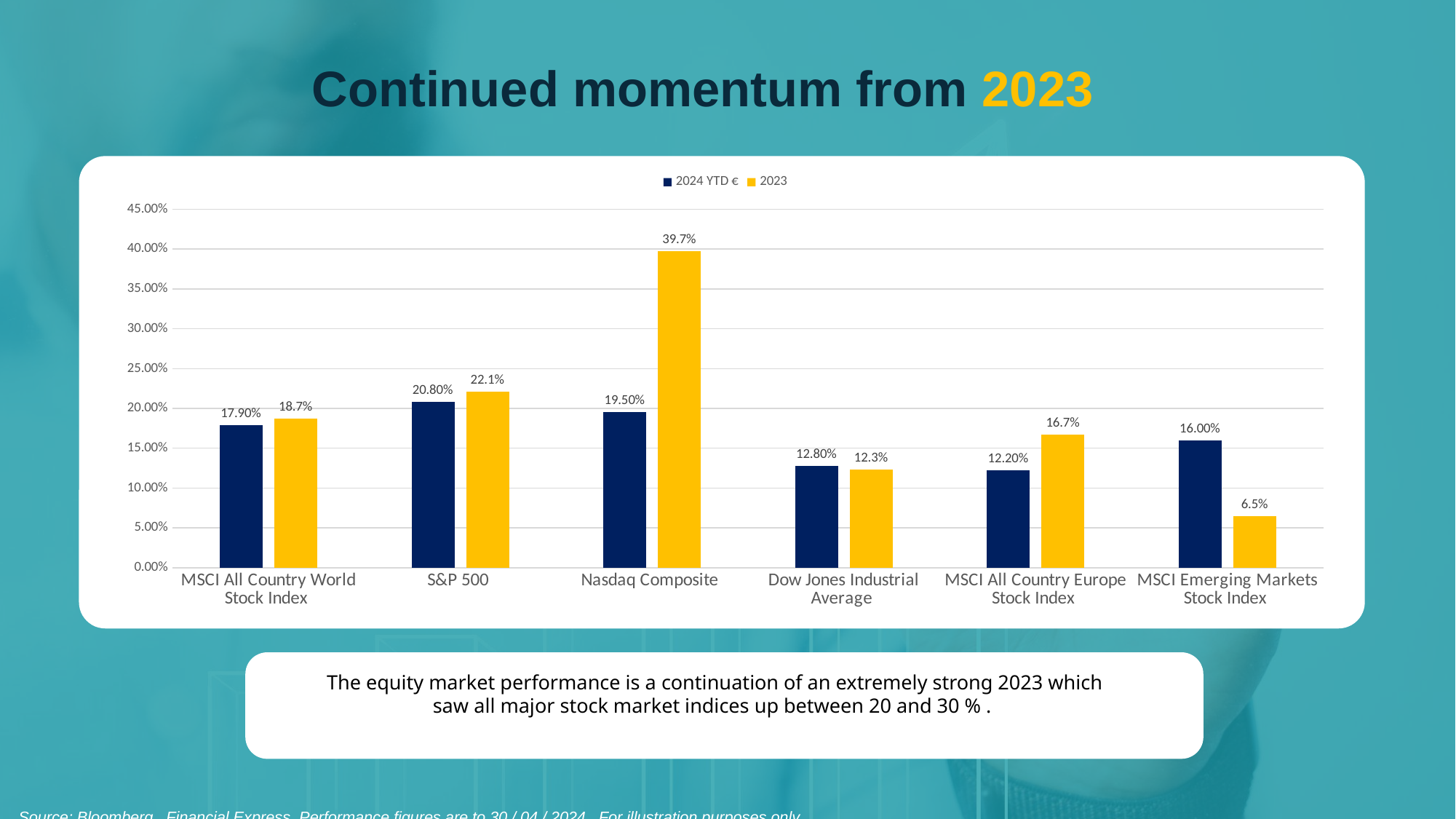
For the MSCI Emerging Markets Stock Index, which is larger: the 2024 YTD € value or the 2023 value? 2024 YTD € Which index has the lowest 2024 YTD € value? MSCI All Country Europe Stock Index What is the difference between the 2023 and 2024 YTD € values for the Nasdaq Composite? 20.2% How many indices are shown on the x axis of the chart? 6 What is the 2024 YTD € value for the Dow Jones Industrial Average? 12.80% Is the 2023 value for the MSCI All Country Europe Stock Index greater or less than 15.00%? greater What type of chart is shown on the slide? Bar chart What is the 2024 YTD € value for the S&P 500? 20.80% Which index has the highest 2023 value? Nasdaq Composite What is the 2023 value for the MSCI Emerging Markets Stock Index? 6.5% How many series does the chart legend list? 2 What is the 2023 value for the Nasdaq Composite? 39.7%